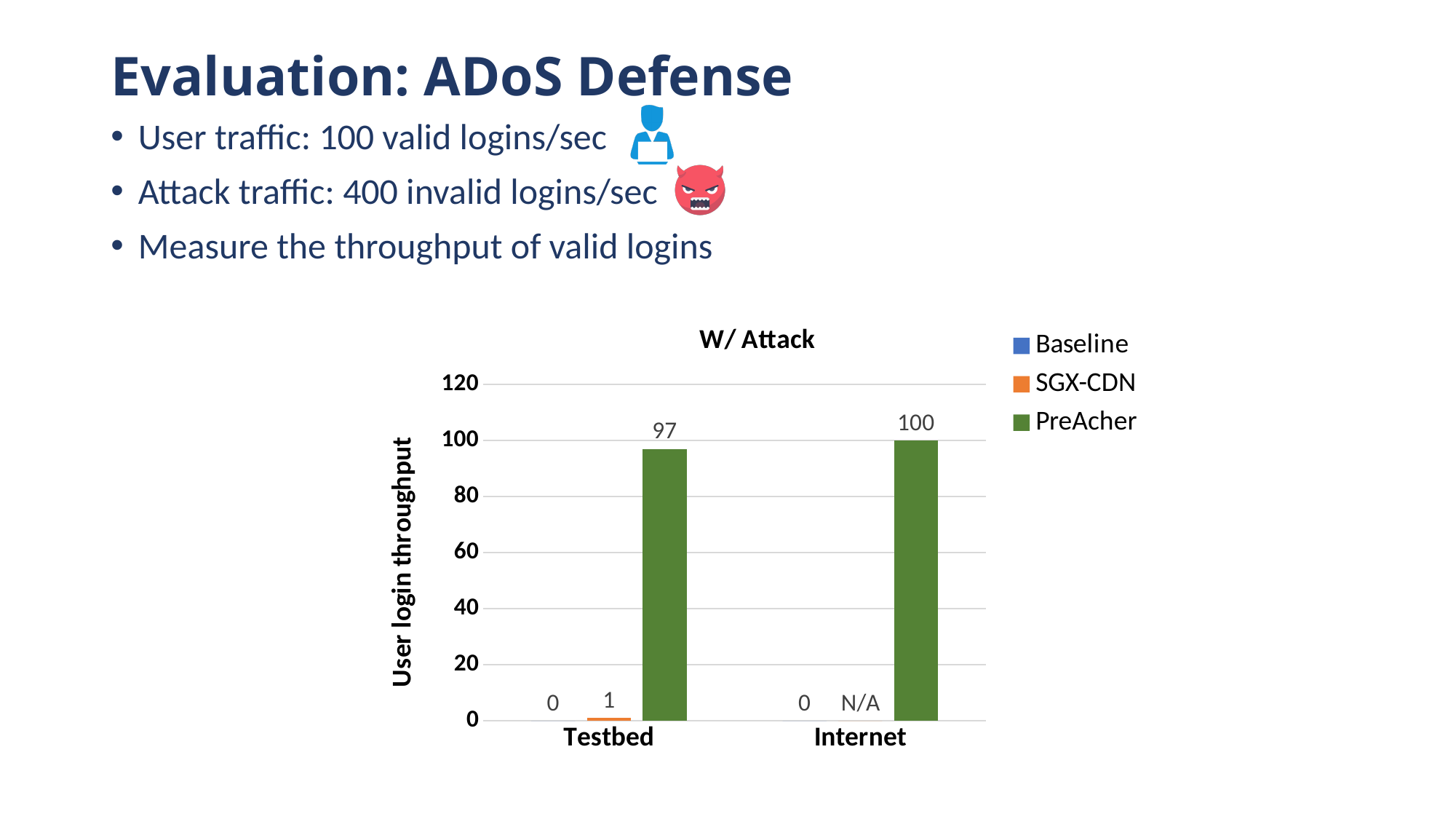
What label is shown for SGX-CDN in the Internet category? N/A What is the SGX-CDN value for Testbed? 1 How many series does the legend list? 3 What is the PreAcher value for Internet? 100 What is the PreAcher value for Testbed? 97 How many categories are shown on the x axis? 2 Which series has the highest value for Testbed? PreAcher What is the difference between the PreAcher values for Internet and Testbed? 3 What kind of chart is shown? bar chart What is the Baseline value for Internet? 0 What is the title of the chart? W/ Attack Which is larger for Testbed, the SGX-CDN value or the Baseline value? SGX-CDN